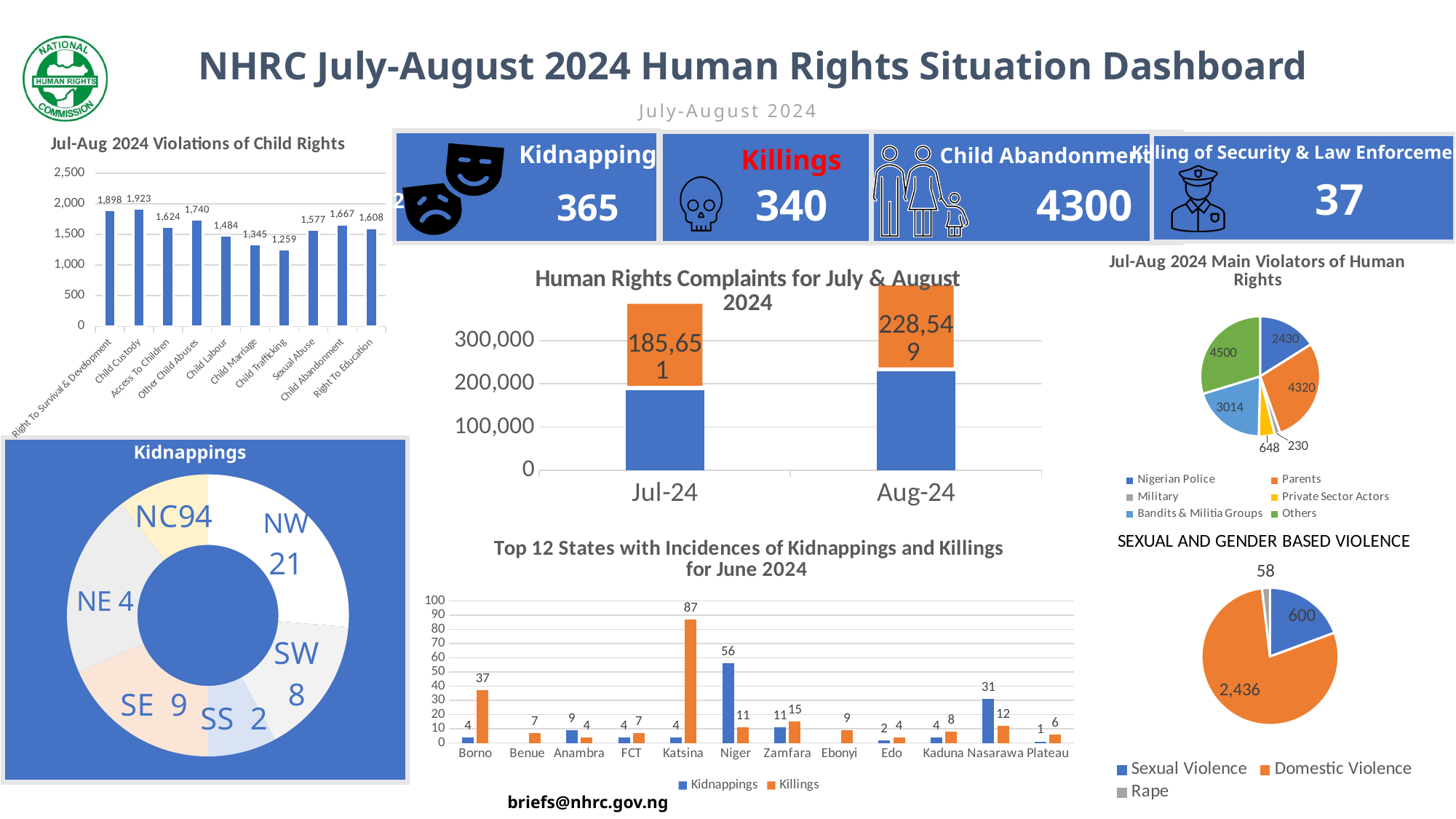
In the 'Jul-Aug 2024 Violations of Child Rights' chart, which category has the highest value? Child Custody In the 'Human Rights Complaints for July & August 2024' chart, what is the labelled value of the orange segment for Aug-24? 228,549 How many series does the legend of the 'Jul-Aug 2024 Main Violators of Human Rights' pie chart list? 6 In the 'Top 12 States with Incidences of Kidnappings and Killings for June 2024' chart, which state has the highest Kidnappings value? Niger In the 'Jul-Aug 2024 Main Violators of Human Rights' pie chart, what is the value for Bandits & Militia Groups? 3014 In the 'SEXUAL AND GENDER BASED VIOLENCE' pie chart, what is the value for Domestic Violence? 2,436 In the 'Jul-Aug 2024 Violations of Child Rights' chart, what is the difference between Child Custody and Right To Survival & Development? 25 In the 'Jul-Aug 2024 Violations of Child Rights' chart, what is the value for Child Trafficking? 1,259 What kind of chart is 'Human Rights Complaints for July & August 2024'? Bar chart In the 'Top 12 States with Incidences of Kidnappings and Killings for June 2024' chart, which is larger for Nasarawa: Kidnappings or Killings? Kidnappings How many categories are shown in the 'Jul-Aug 2024 Violations of Child Rights' chart? 10 In the 'Top 12 States with Incidences of Kidnappings and Killings for June 2024' chart, what is the Killings value for Katsina? 87